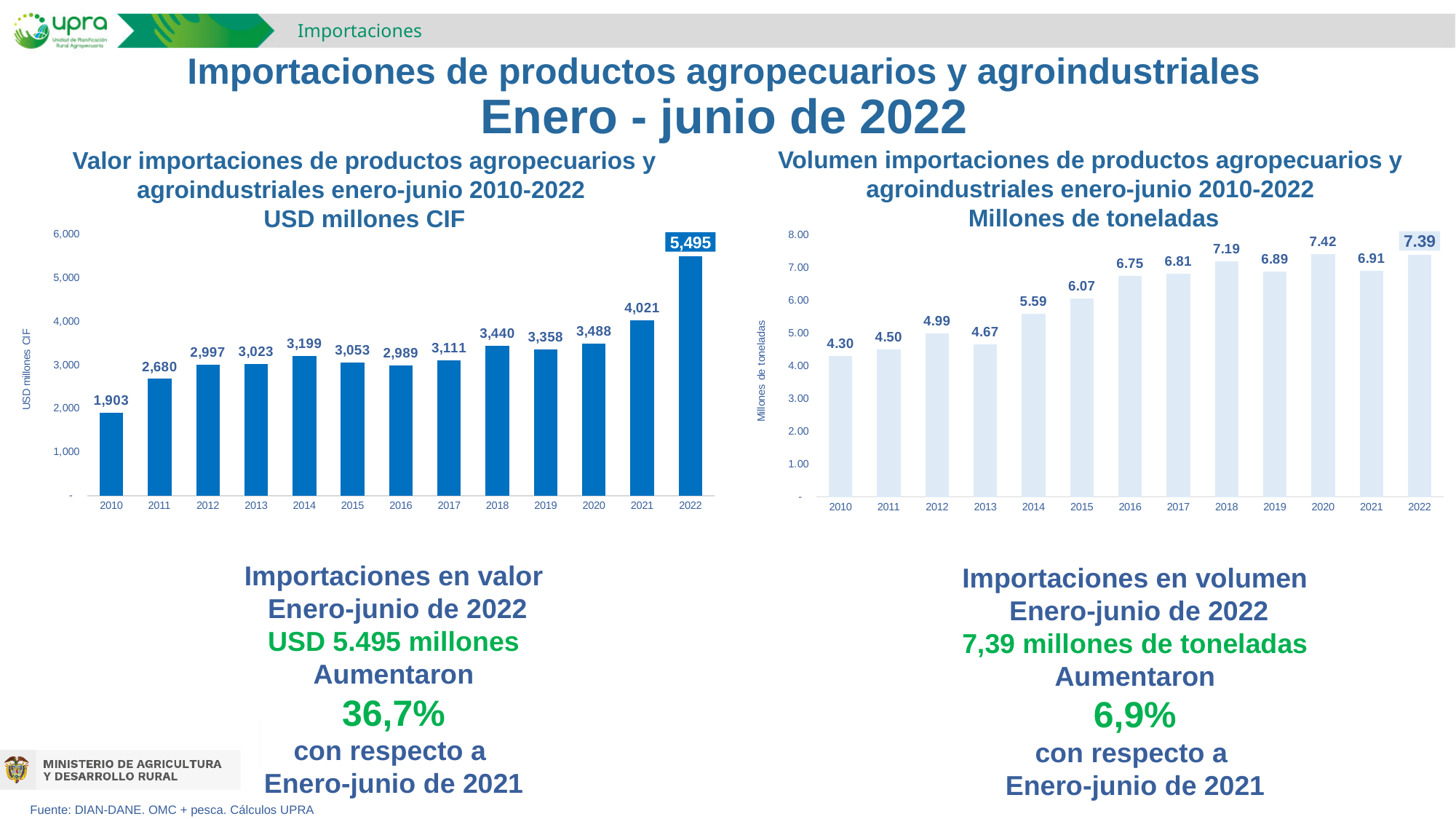
In the left chart (Valor importaciones, USD millones CIF), what is the value for 2010? 1,903 In the left chart (Valor importaciones, USD millones CIF), what is the difference between the 2022 and 2021 values? 1,474 In the left chart (Valor importaciones, USD millones CIF), which is larger, the value for 2018 or the value for 2019? 2018 In the left chart (Valor importaciones, USD millones CIF), which year has the lowest value? 2010 What kind of chart is the right chart (Volumen importaciones, Millones de toneladas)? Bar chart In the right chart (Volumen importaciones, Millones de toneladas), what is the difference between the 2022 and 2021 values? 0.48 In the right chart (Volumen importaciones, Millones de toneladas), which year has the highest value? 2020 In the right chart (Volumen importaciones, Millones de toneladas), what is the value for 2020? 7.42 In the left chart (Valor importaciones, USD millones CIF), what is the value for 2022? 5,495 In the right chart (Volumen importaciones, Millones de toneladas), which year has the lowest value? 2010 In the left chart (Valor importaciones, USD millones CIF), how many years are plotted? 13 What is the y-axis label of the left chart (Valor importaciones)? USD millones CIF